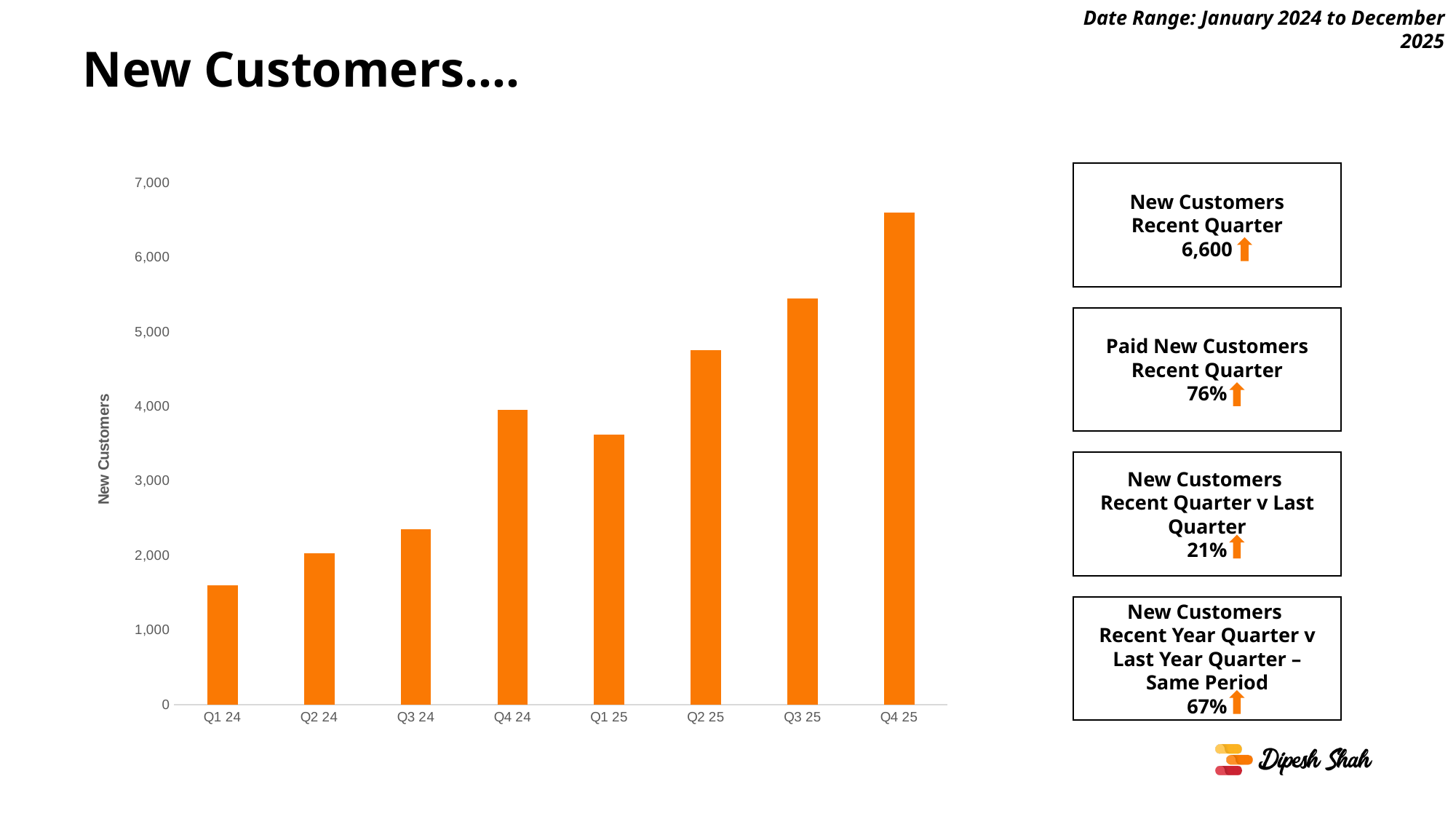
How many quarters are plotted on the chart? 8 Which quarter has the highest number of new customers? Q4 25 Is the value for Q3 25 greater or less than 5,000? greater What kind of chart is shown on the slide? bar chart What is the label on the vertical axis of the chart? New Customers Which quarter has the lowest number of new customers? Q1 24 Is the value for Q1 25 greater or less than 4,000? less What is the number of new customers for Q4 25, the most recent quarter? 6,600 Is the value for Q3 24 greater or less than 2,000? greater Which is larger, the value for Q4 24 or the value for Q1 25? Q4 24